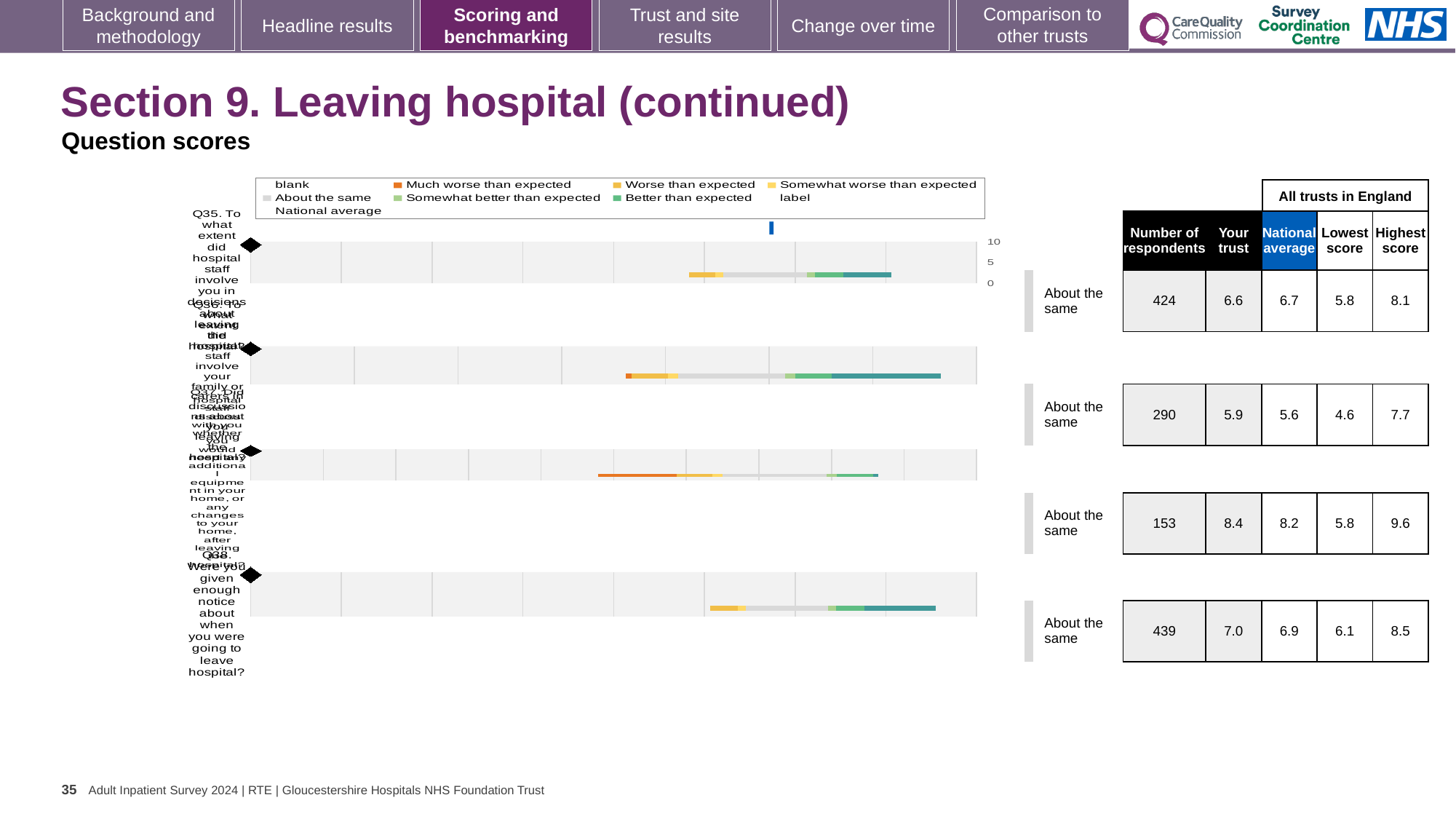
In the table, what is the national average for Q35 (the first row)? 6.7 For Q38 (the last row), which is larger: the 'Your trust' score or the national average? Your trust In the table, what is the 'Your trust' score for Q38 (the last row)? 7.0 In the table, what is the number of respondents for Q35 (the first row)? 424 How many question rows are plotted in the chart? 4 What benchmark category is shown next to each of the four question rows? About the same For Q35 (the first row), what is the difference between the national average and the 'Your trust' score? 0.1 What kind of chart is used to show the question scores on this slide? bar chart For Q38 (the last row), what is the difference between the highest score and the lowest score among all trusts in England? 2.4 What is the smallest value in the 'Lowest score' column of the table? 4.6 In the table, what is the highest score among all trusts in England for Q38 (the last row)? 8.5 What is the highest 'Your trust' score shown in the table? 8.4